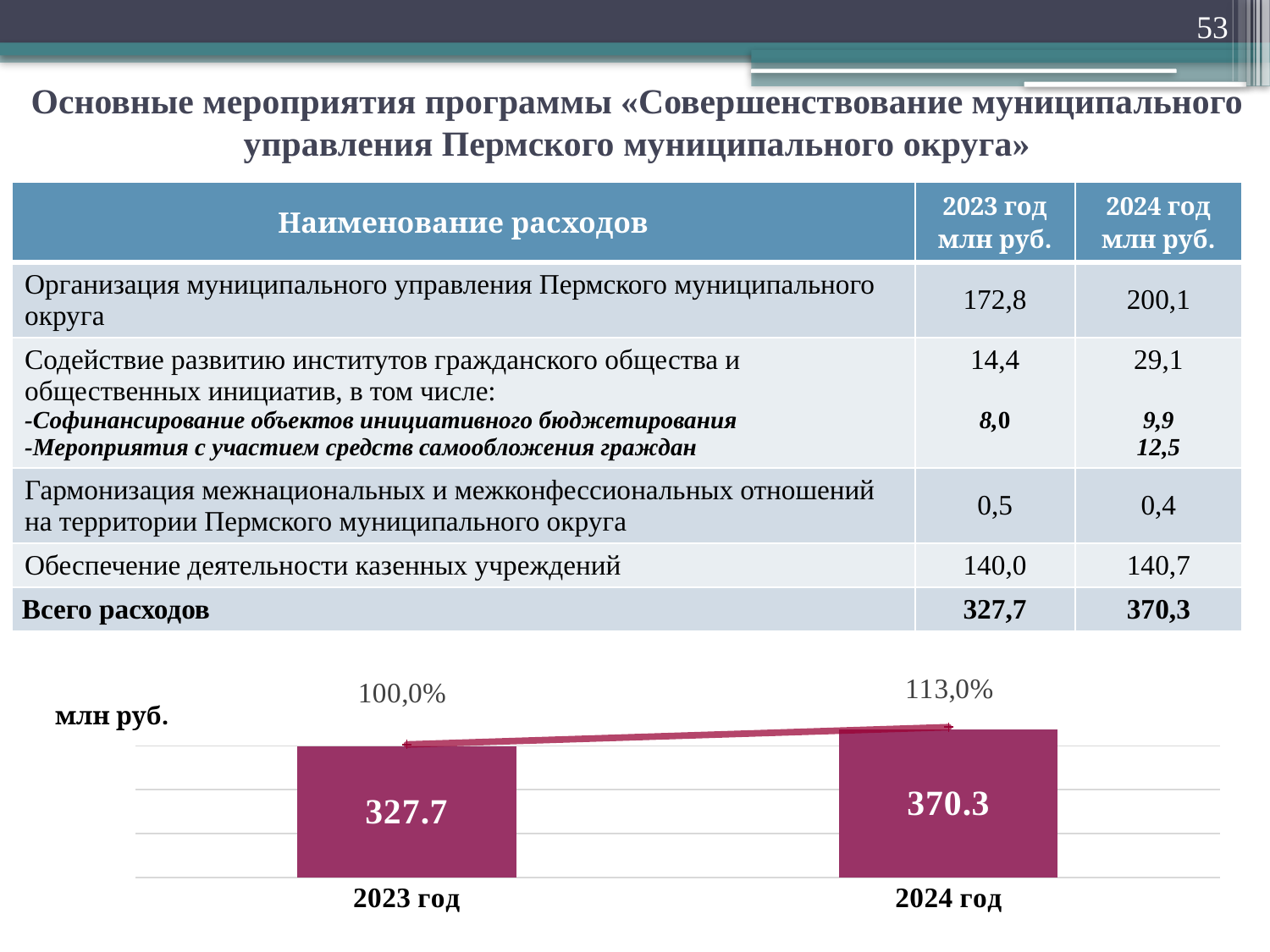
What unit label is shown at the top left of the chart? млн руб. What is the value of the bar for 2024 год? 370.3 Which year has the higher bar in the chart? 2024 год What percentage label is shown above the 2024 год bar? 113,0% Which year has the lower bar in the chart? 2023 год Is the value for 2024 год larger or smaller than the value for 2023 год? larger How many bars (categories) does the chart show? 2 What type of chart is shown at the bottom of the slide? combination bar and line chart What is the difference between the 2024 год bar and the 2023 год bar? 42.6 Do the values rise or fall from 2023 год to 2024 год? rise What percentage label is shown above the 2023 год bar? 100,0% What is the value of the bar for 2023 год? 327.7